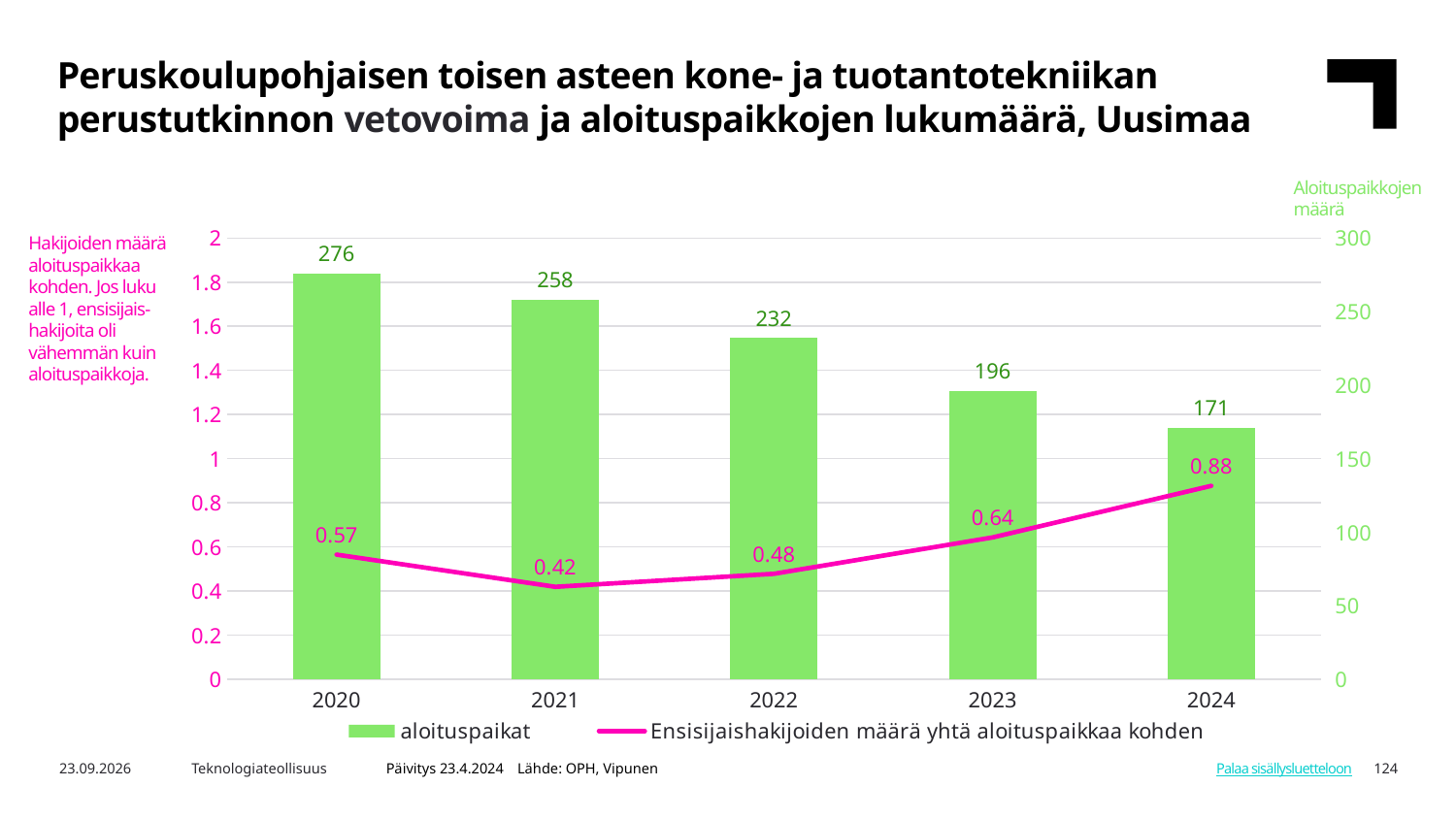
Do the aloituspaikat values rise or fall from 2020 to 2024? fall What is the value of aloituspaikat for 2024? 171 How many years are shown on the x axis? 5 What is the difference in aloituspaikat between 2020 and 2024? 105 Which year has a larger value of Ensisijaishakijoiden määrä yhtä aloituspaikkaa kohden, 2023 or 2024? 2024 What colour are the aloituspaikat bars? green Which year has the highest value of aloituspaikat? 2020 What kind of chart is used for the aloituspaikat series? bar chart What is the value of aloituspaikat for 2020? 276 Which year has the lowest value of Ensisijaishakijoiden määrä yhtä aloituspaikkaa kohden? 2021 How many series does the legend list? 2 What is the value of Ensisijaishakijoiden määrä yhtä aloituspaikkaa kohden for 2021? 0.42